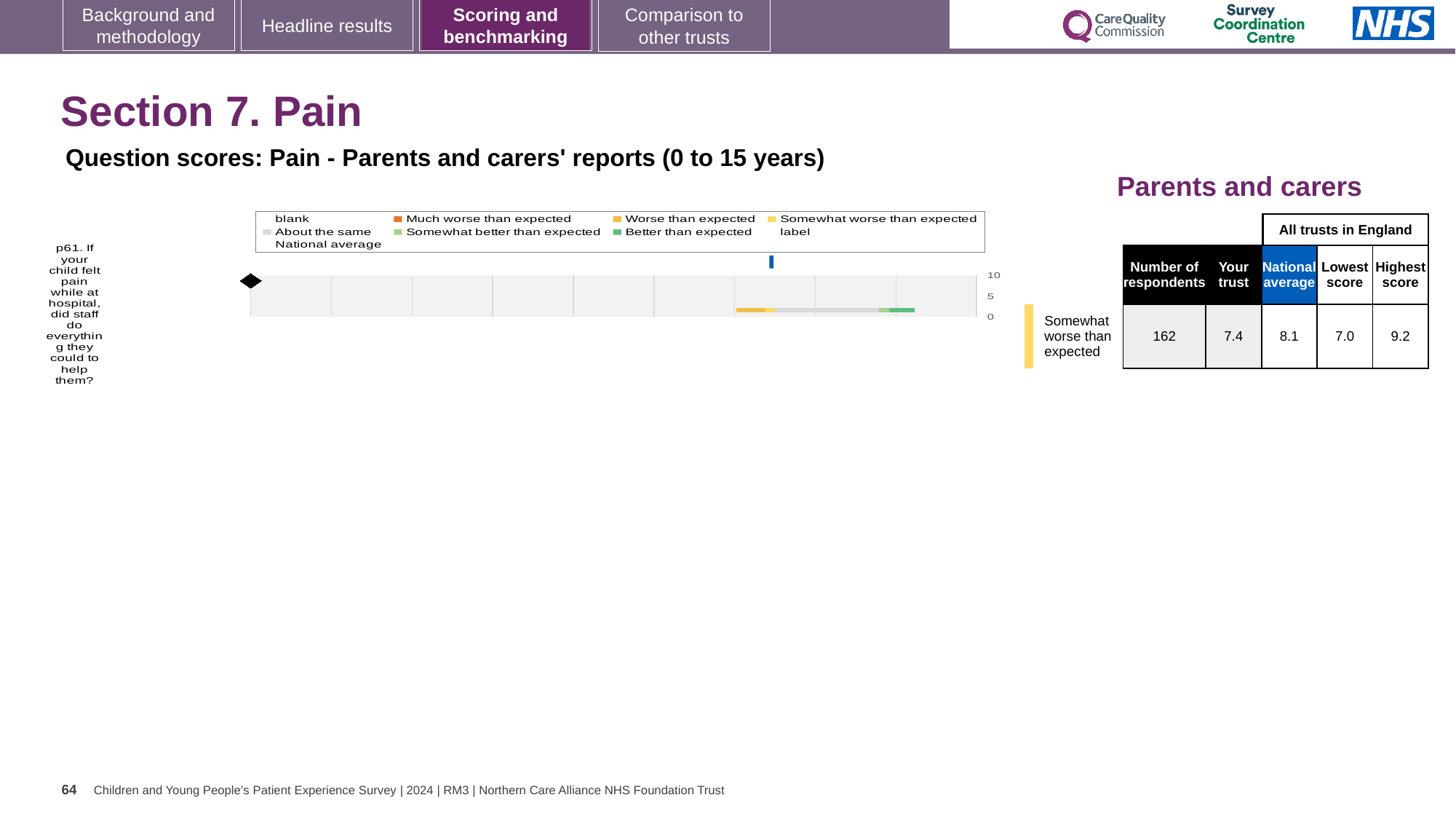
What kind of chart is shown on the slide? bar chart According to the table beside the chart, what is the lowest score among all trusts in England for question p61? 7.0 Which is larger for question p61: the trust's score or the national average? national average According to the table beside the chart, what is the national average score for question p61? 8.1 What is the difference between the national average (8.1) and the trust's score (7.4) for question p61? 0.7 What is the highest tick value shown on the chart's score axis? 10 How many survey questions (categories) are plotted in the chart? 1 According to the table beside the chart, what is the highest score among all trusts in England for question p61? 9.2 What is the question number of the item plotted in the chart? p61 According to the table beside the chart, what is the 'Your trust' score for question p61? 7.4 What benchmark category is the trust's score for question p61 placed in? Somewhat worse than expected How many respondents answered question p61, according to the table? 162